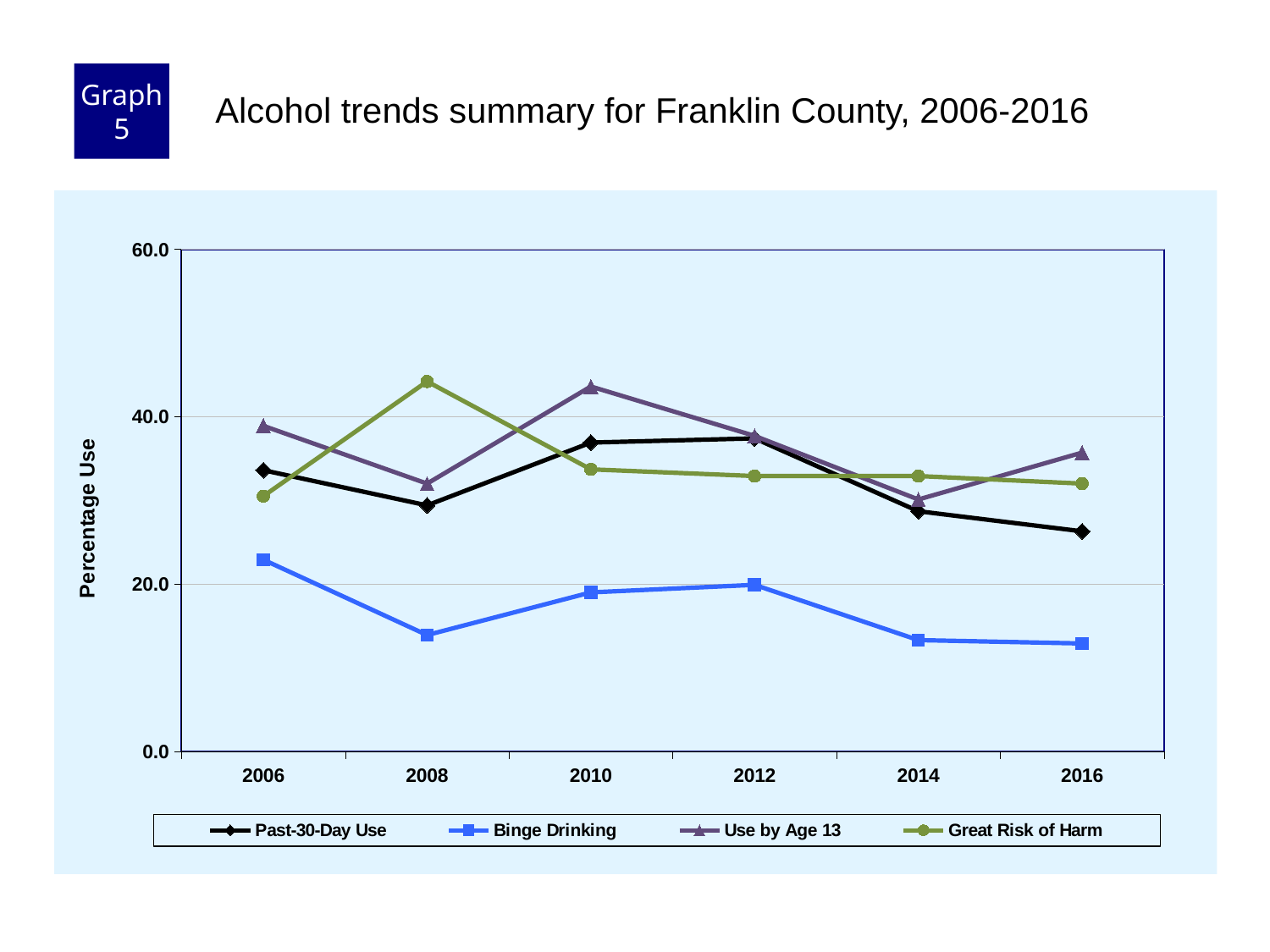
Which series has the highest value in 2008? Great Risk of Harm Which series has the lowest value in every year shown? Binge Drinking Is the value for Binge Drinking in 2008 greater or less than 20.0? less Is the value for Binge Drinking in 2006 greater or less than 20.0? greater How many series does the legend list? 4 Which is larger for Past-30-Day Use: the value in 2006 or the value in 2016? 2006 How many years are plotted along the x axis? 6 Is the value for Use by Age 13 in 2008 greater or less than 40.0? less Does the Binge Drinking line rise or fall from 2012 to 2016? Fall What is the label on the y axis? Percentage Use What kind of chart is shown on the slide? Line chart